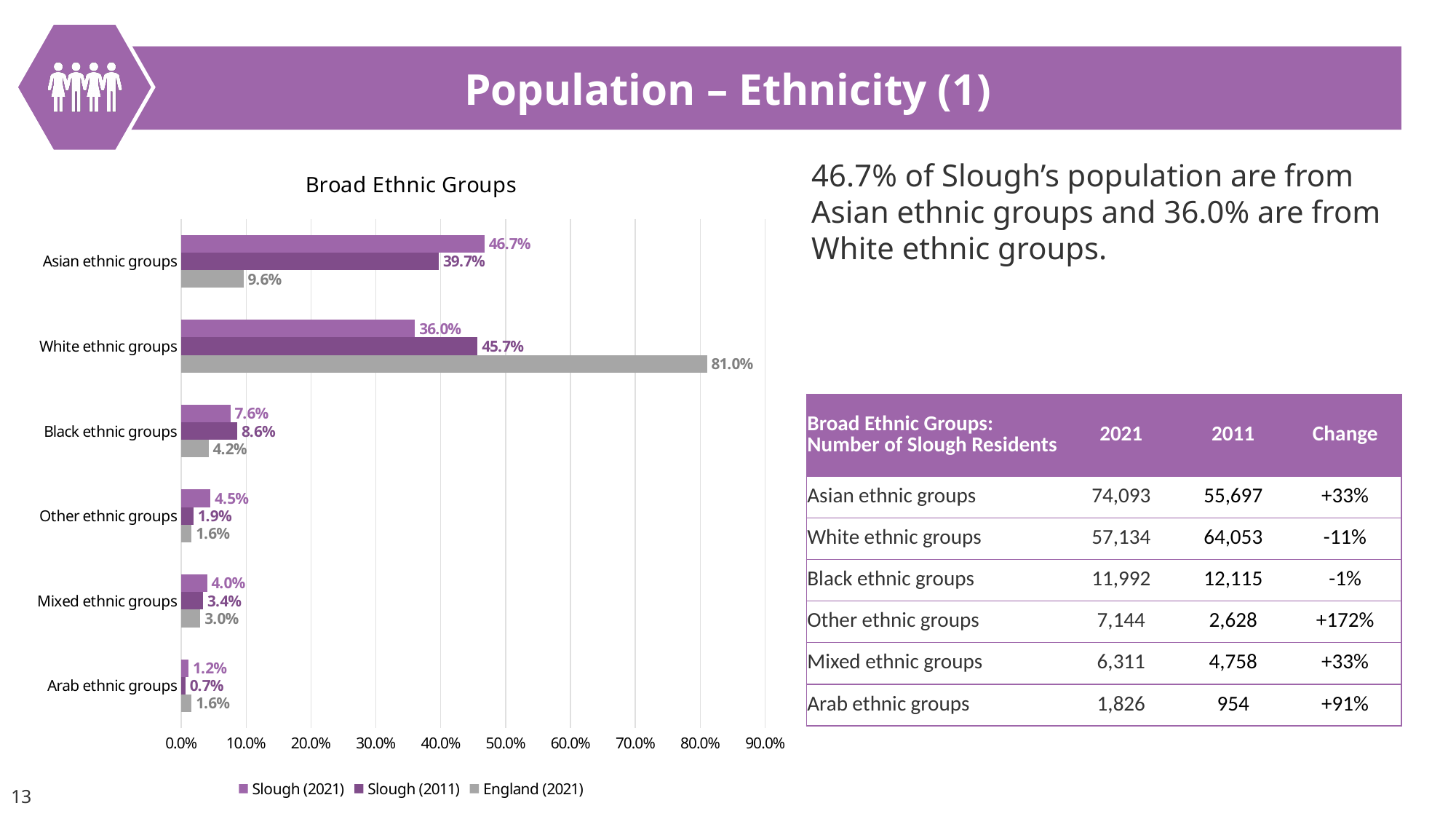
What is the difference between the Slough (2011) and Slough (2021) values for White ethnic groups? 9.7% How many ethnic group categories are shown in the chart? 6 Which is larger for Other ethnic groups: the Slough (2021) value or the Slough (2011) value? Slough (2021) Which category has the lowest Slough (2011) value? Arab ethnic groups What is the title of the chart? Broad Ethnic Groups What is the England (2021) value for White ethnic groups? 81.0% Which category has the highest Slough (2021) value? Asian ethnic groups What type of chart is shown on the slide? Bar chart How many series does the chart legend list? 3 What is the Slough (2011) value for Black ethnic groups? 8.6% What is the Slough (2021) value for Asian ethnic groups? 46.7% Is the England (2021) value for Asian ethnic groups greater or less than 10.0%? less